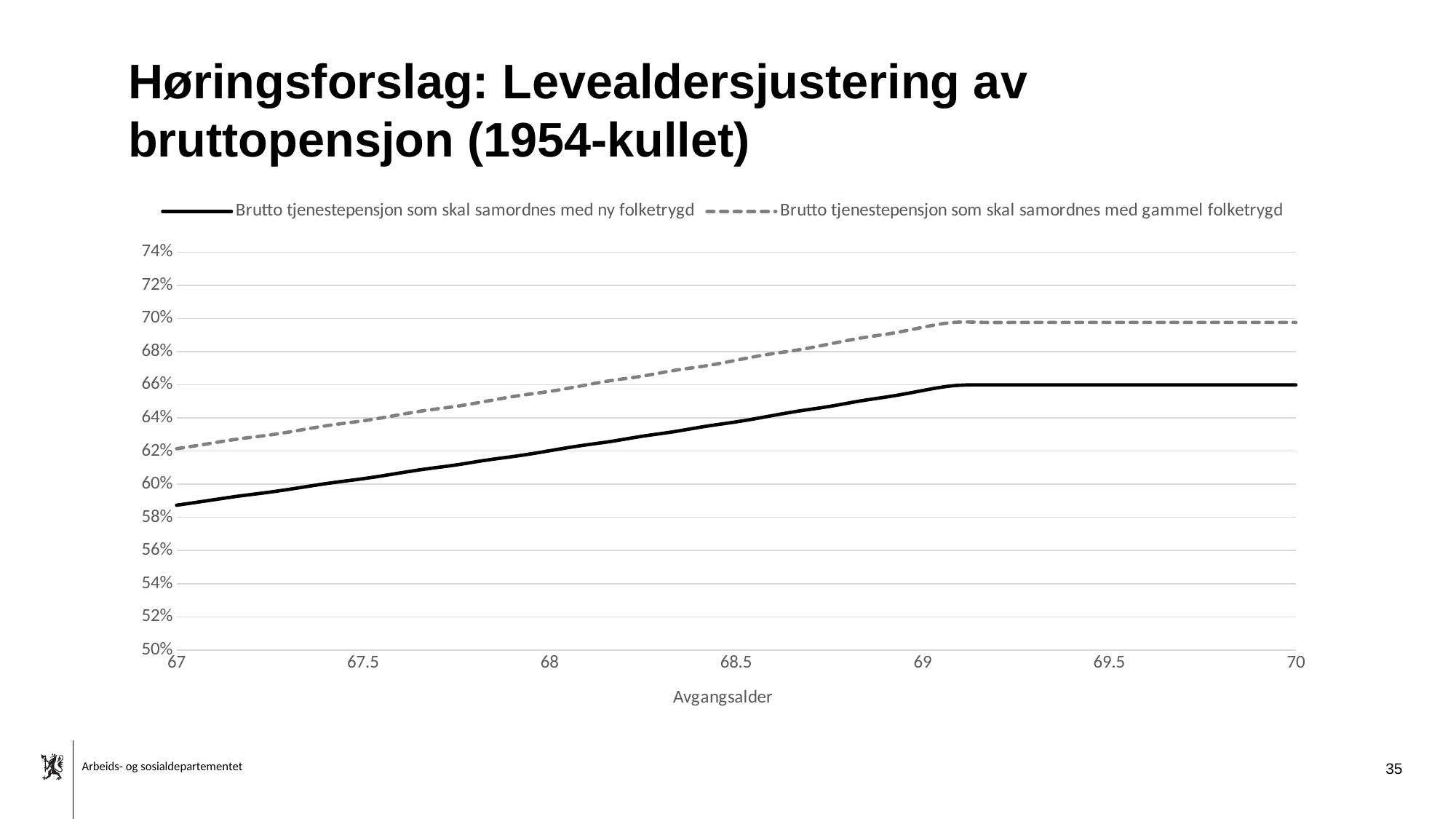
Do the values for 'Brutto tjenestepensjon som skal samordnes med ny folketrygd' rise or fall from avgangsalder 67 to 69? rise Is the value for 'Brutto tjenestepensjon som skal samordnes med ny folketrygd' at avgangsalder 67 greater or less than 60%? less Do the values for 'Brutto tjenestepensjon som skal samordnes med gammel folketrygd' rise or fall from avgangsalder 67 to 69? rise At avgangsalder 67, which series has the higher value: the one samordnet med ny folketrygd or the one samordnet med gammel folketrygd? Brutto tjenestepensjon som skal samordnes med gammel folketrygd How many series does the legend list? 2 Is the value for 'Brutto tjenestepensjon som skal samordnes med gammel folketrygd' at avgangsalder 70 greater or less than 68%? greater Is the value for 'Brutto tjenestepensjon som skal samordnes med gammel folketrygd' at avgangsalder 67 greater or less than 64%? less Which series is drawn with a dashed line? Brutto tjenestepensjon som skal samordnes med gammel folketrygd What is the title of the x axis? Avgangsalder What kind of chart is shown on the slide? line chart